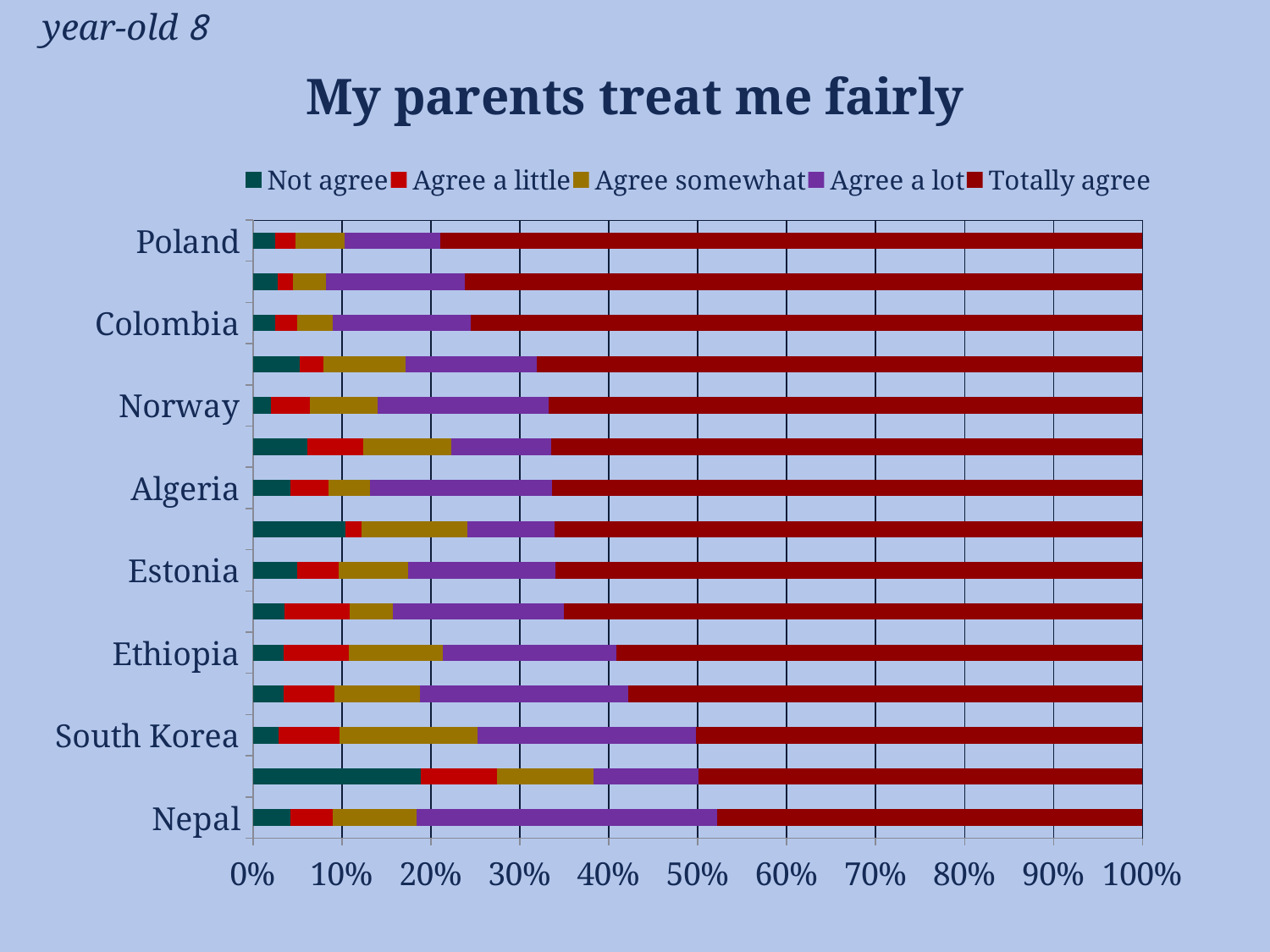
Which country has the smallest 'Totally agree' share? Nepal Is the 'Totally agree' share for Poland greater or less than 70%? greater How many country labels are shown on the vertical axis? 8 What is the title of the chart? My parents treat me fairly Which country has the largest 'Agree a lot' share? Nepal Is the 'Not agree' share for Poland greater or less than 10%? less What kind of chart is shown on the slide? Stacked bar chart How many series does the legend list? 5 Is the 'Agree a lot' share for Nepal greater or less than 30%? greater Which has the larger 'Totally agree' share, Poland or Nepal? Poland Which series is shown in dark red in the chart? Totally agree